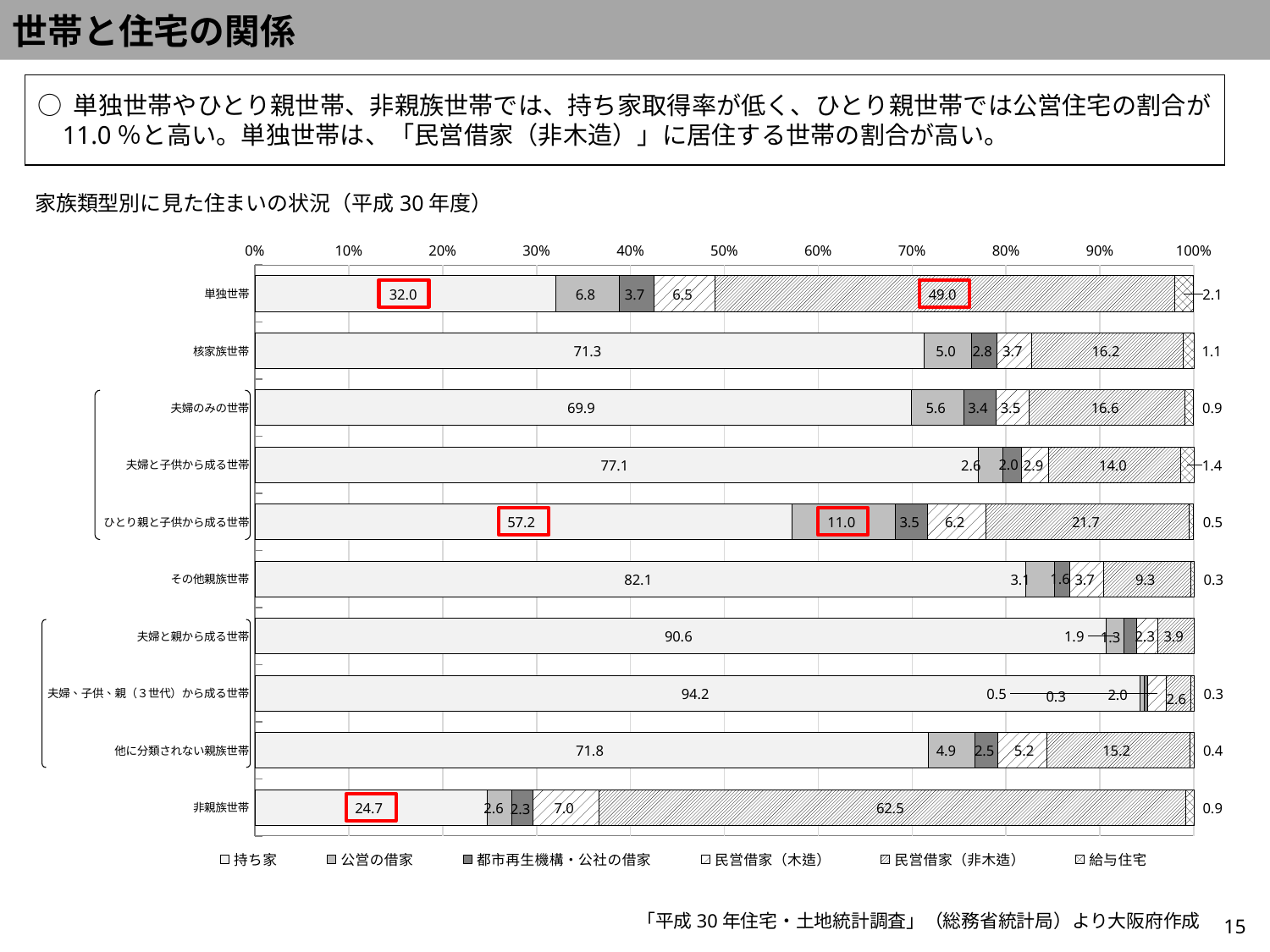
Which household category has the lowest 持ち家 value? 非親族世帯 What is the 民営借家（非木造） value for 非親族世帯? 62.5 How many household categories are plotted on the chart? 10 How many series does the legend list? 6 What is the title of the chart? 家族類型別に見た住まいの状況（平成30年度） What kind of chart is shown on the slide? Stacked bar chart What is the 公営の借家 value for ひとり親と子供から成る世帯? 11.0 What is the 持ち家 value for 単独世帯? 32.0 What is the 給与住宅 value for 夫婦と子供から成る世帯? 1.4 Which is larger, the 民営借家（非木造） value for 単独世帯 or for ひとり親と子供から成る世帯? 単独世帯 What is the difference between the 持ち家 values for 核家族世帯 and 単独世帯? 39.3 Which household category has the highest 持ち家 value? 夫婦、子供、親（3世代）から成る世帯